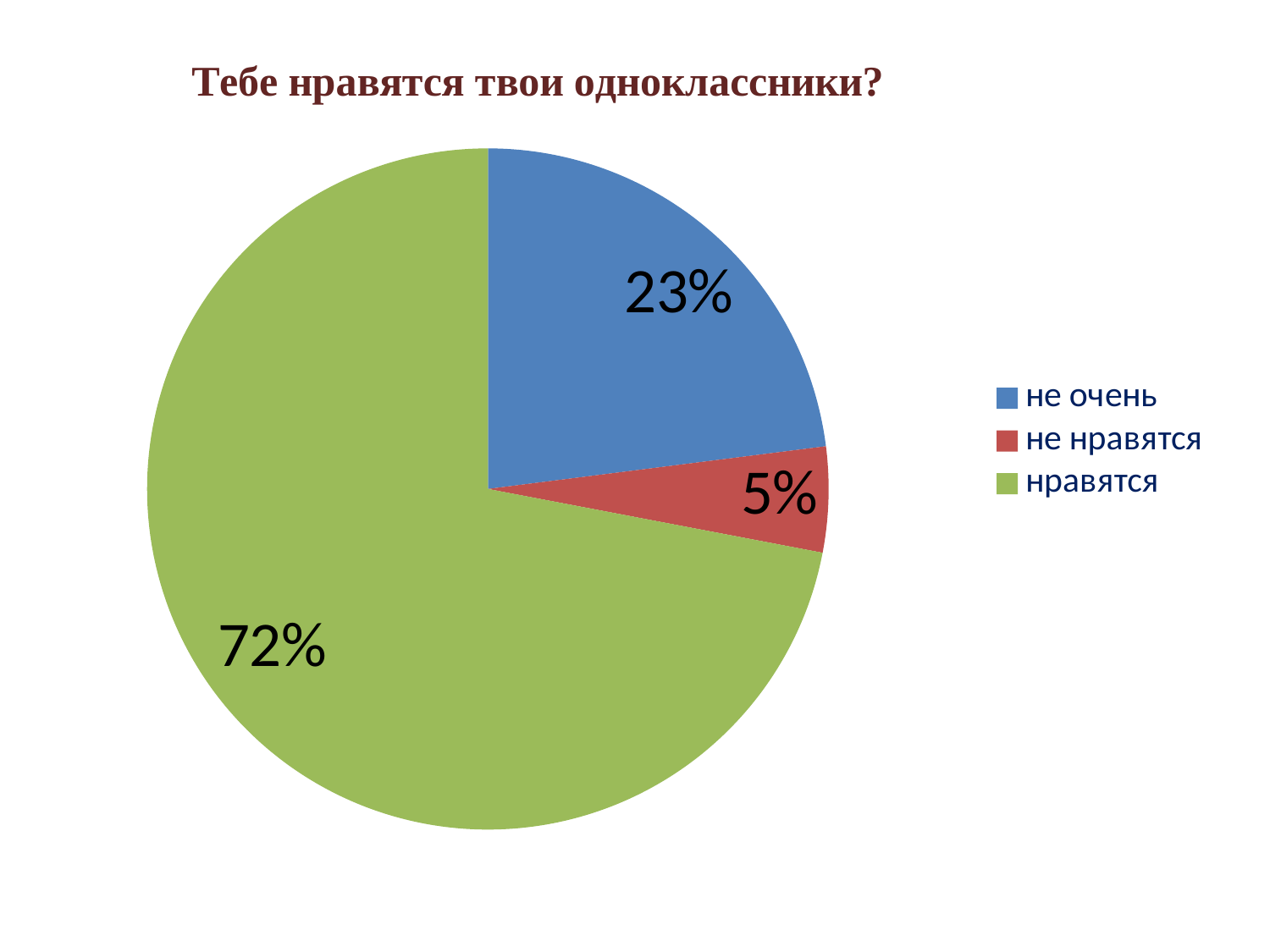
What is the difference in percentage points between "не очень" and "не нравятся"? 18 What is the title of the chart? Тебе нравятся твои одноклассники? What is the difference in percentage points between "нравятся" and "не очень"? 49 Which category has the smallest slice of the pie? не нравятся What colour is the slice for "не нравятся"? red What kind of chart is shown on the slide? pie chart Which is larger, the slice for "не очень" or the slice for "не нравятся"? не очень What share of the pie does "не очень" take? 23% What share of the pie does "не нравятся" take? 5% Which category has the largest slice of the pie? нравятся What share of the pie does "нравятся" take? 72% How many categories does the pie chart have? 3